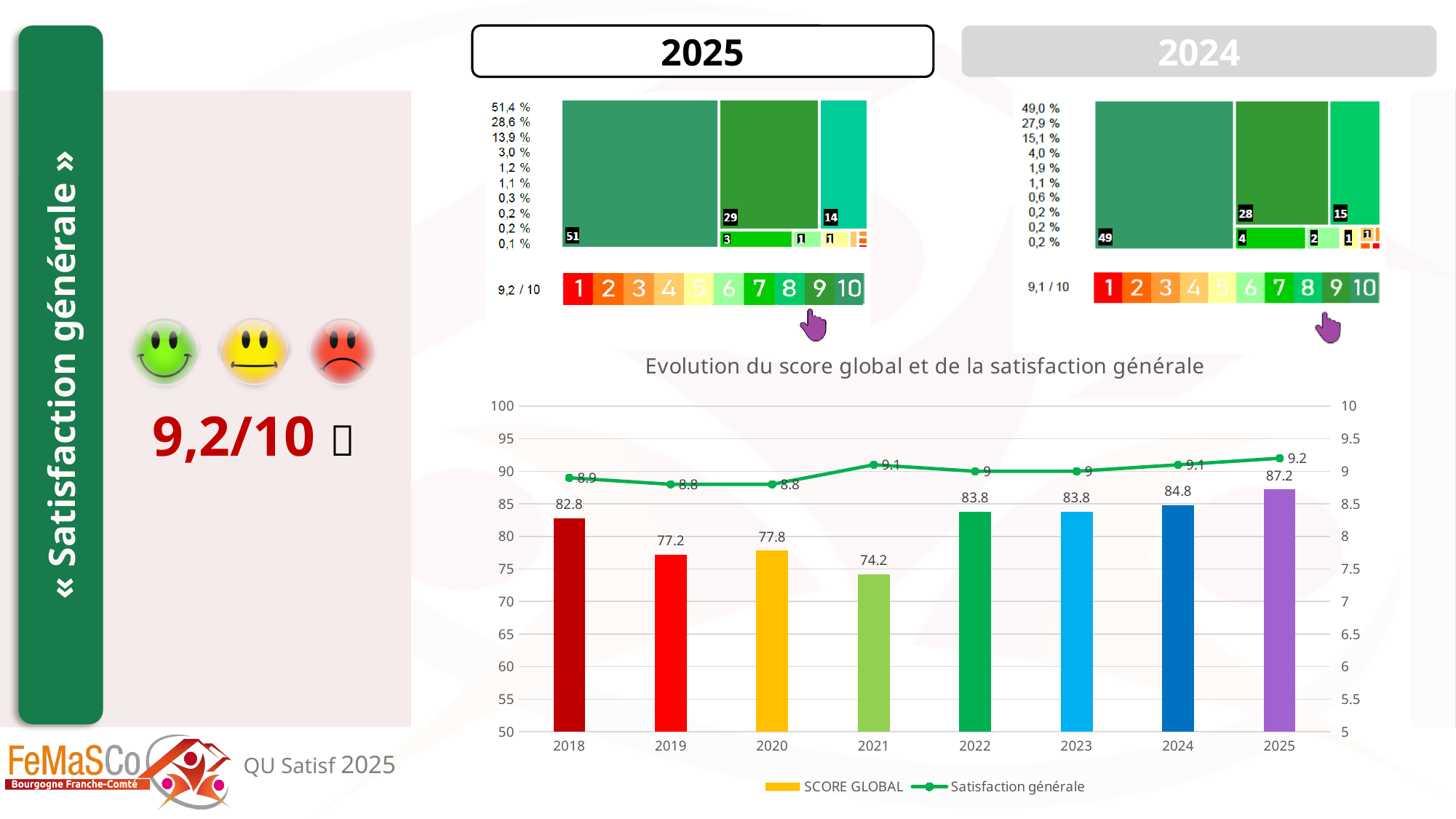
In the chart 'Evolution du score global et de la satisfaction générale', what is the Satisfaction générale value for 2018? 8.9 In the chart 'Evolution du score global et de la satisfaction générale', which year has the highest SCORE GLOBAL? 2025 In the chart 'Evolution du score global et de la satisfaction générale', what kind of chart is used for the SCORE GLOBAL series? Bar chart In the chart 'Evolution du score global et de la satisfaction générale', how many series does the legend list? 2 In the chart 'Evolution du score global et de la satisfaction générale', which year has the lowest SCORE GLOBAL? 2021 In the chart 'Evolution du score global et de la satisfaction générale', what is the SCORE GLOBAL value for 2025? 87.2 In the chart 'Evolution du score global et de la satisfaction générale', does the SCORE GLOBAL rise or fall from 2021 to 2025? Rise In the chart 'Evolution du score global et de la satisfaction générale', how many years are shown on the x axis? 8 In the chart 'Evolution du score global et de la satisfaction générale', what is the difference between the SCORE GLOBAL for 2025 and 2024? 2.4 In the chart 'Evolution du score global et de la satisfaction générale', what is the Satisfaction générale value for 2021? 9.1 In the chart 'Evolution du score global et de la satisfaction générale', which year has the larger SCORE GLOBAL, 2019 or 2020? 2020 In the chart 'Evolution du score global et de la satisfaction générale', what is the difference between the Satisfaction générale values for 2025 and 2019? 0.4